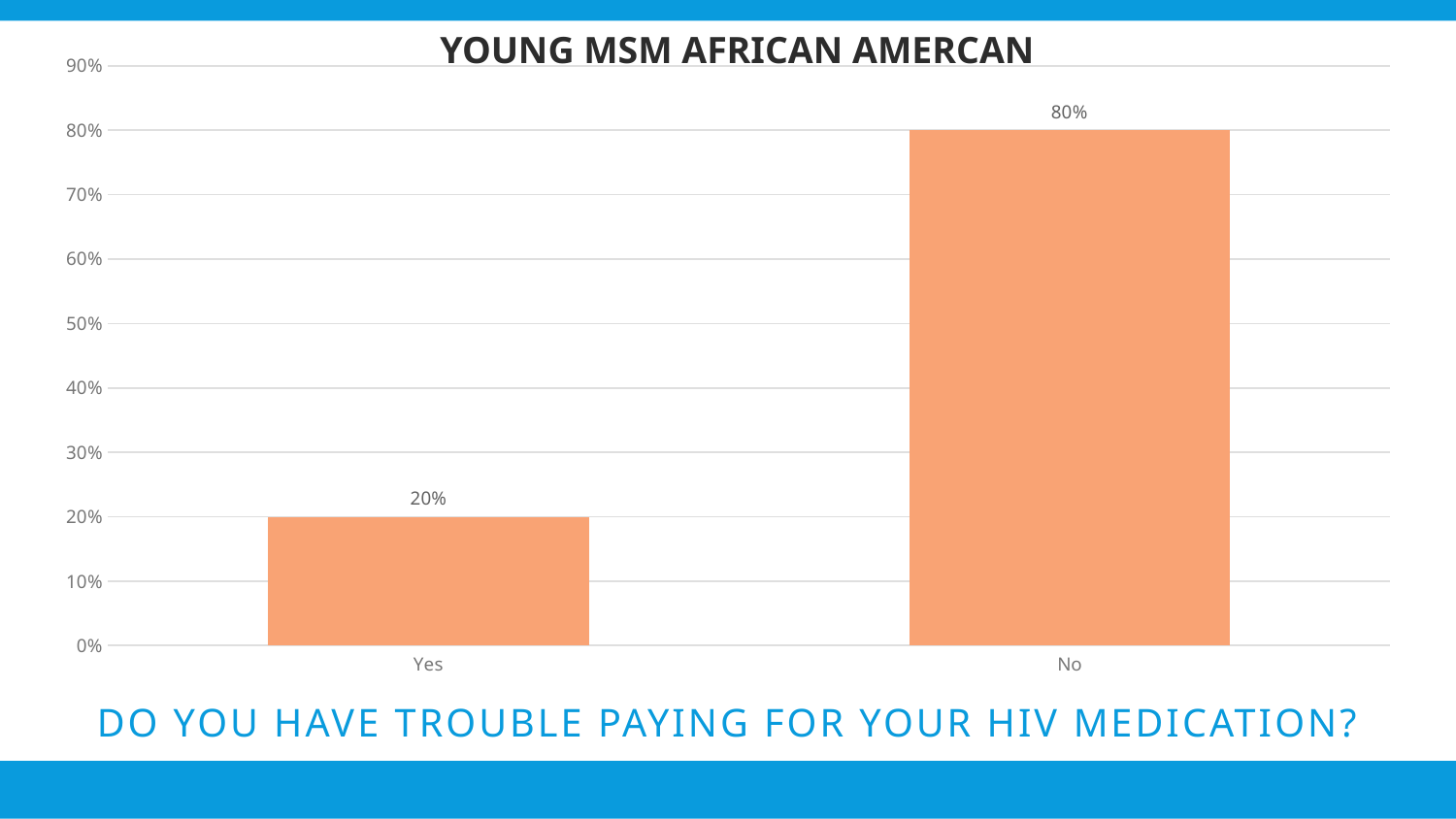
What is the value for "Yes"? 20% What is the highest value shown on the y axis? 90% Which category has the lowest value? Yes Which category has the highest value? No Which is larger, the value for "Yes" or the value for "No"? No How many categories are shown on the x axis? 2 What is the title of the chart? YOUNG MSM AFRICAN AMERCAN What is the value for "No"? 80% Is the value for "No" greater or less than 50%? greater Is the value for "Yes" greater or less than 30%? less What is the difference between the values for "No" and "Yes"? 60% What kind of chart is shown on the slide? Bar chart